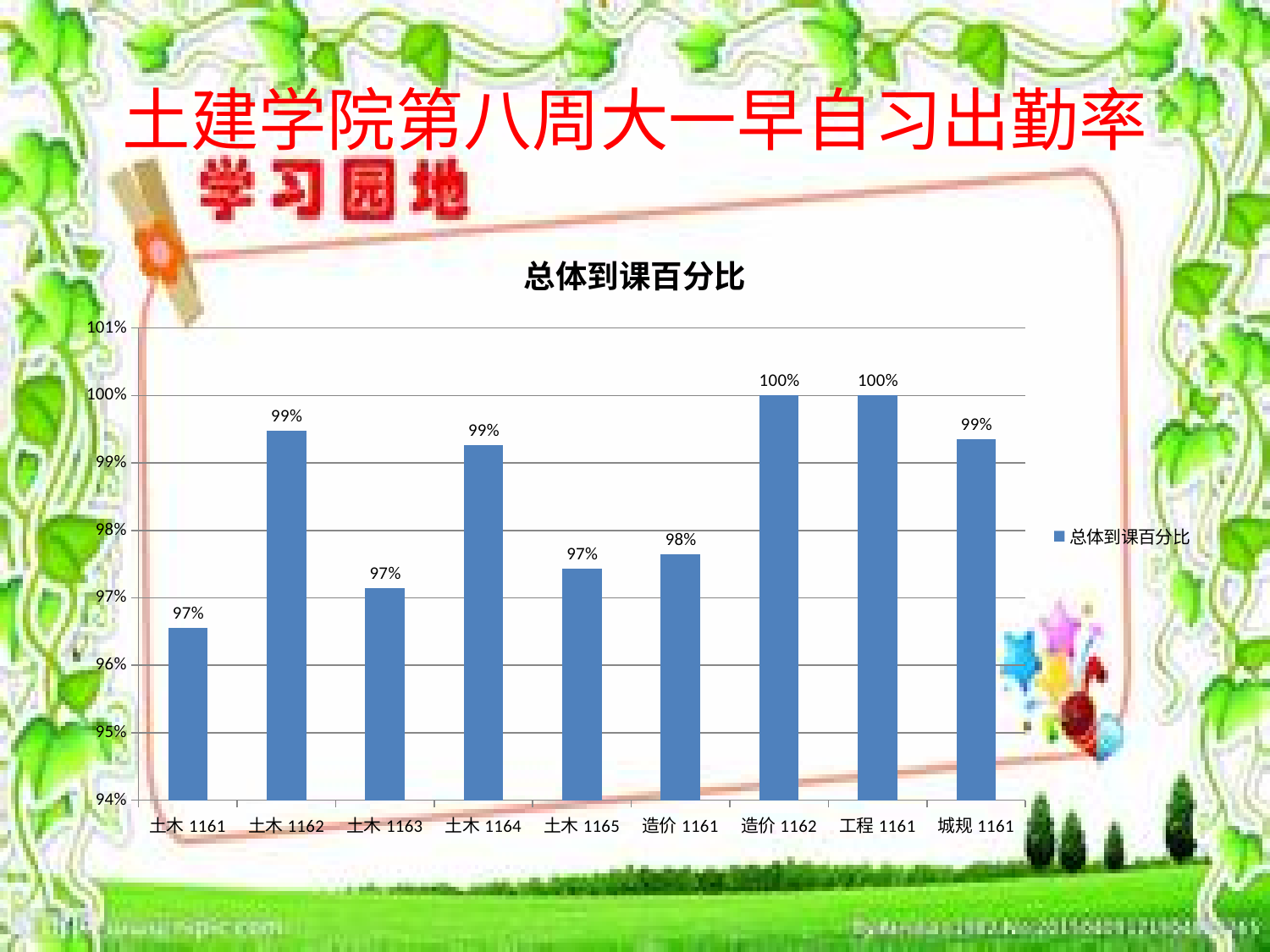
What is the attendance percentage shown for 土木 1162? 99% Is the value for 土木 1164 greater or less than 98%? greater How many classes (categories) are shown on the x axis of the chart? 9 Is the value for 土木 1161 greater or less than 98%? less What type of chart is shown on the slide? bar chart What is the attendance percentage shown for 造价 1161? 98% How many series does the chart legend list? 1 What is the attendance percentage shown for 工程 1161? 100% What is the difference between the labelled values for 造价 1162 and 土木 1161? 3% Which class has the lowest attendance percentage in the chart? 土木 1161 What is the title of the chart? 总体到课百分比 Which has a higher attendance percentage, 土木 1162 or 土木 1163? 土木 1162